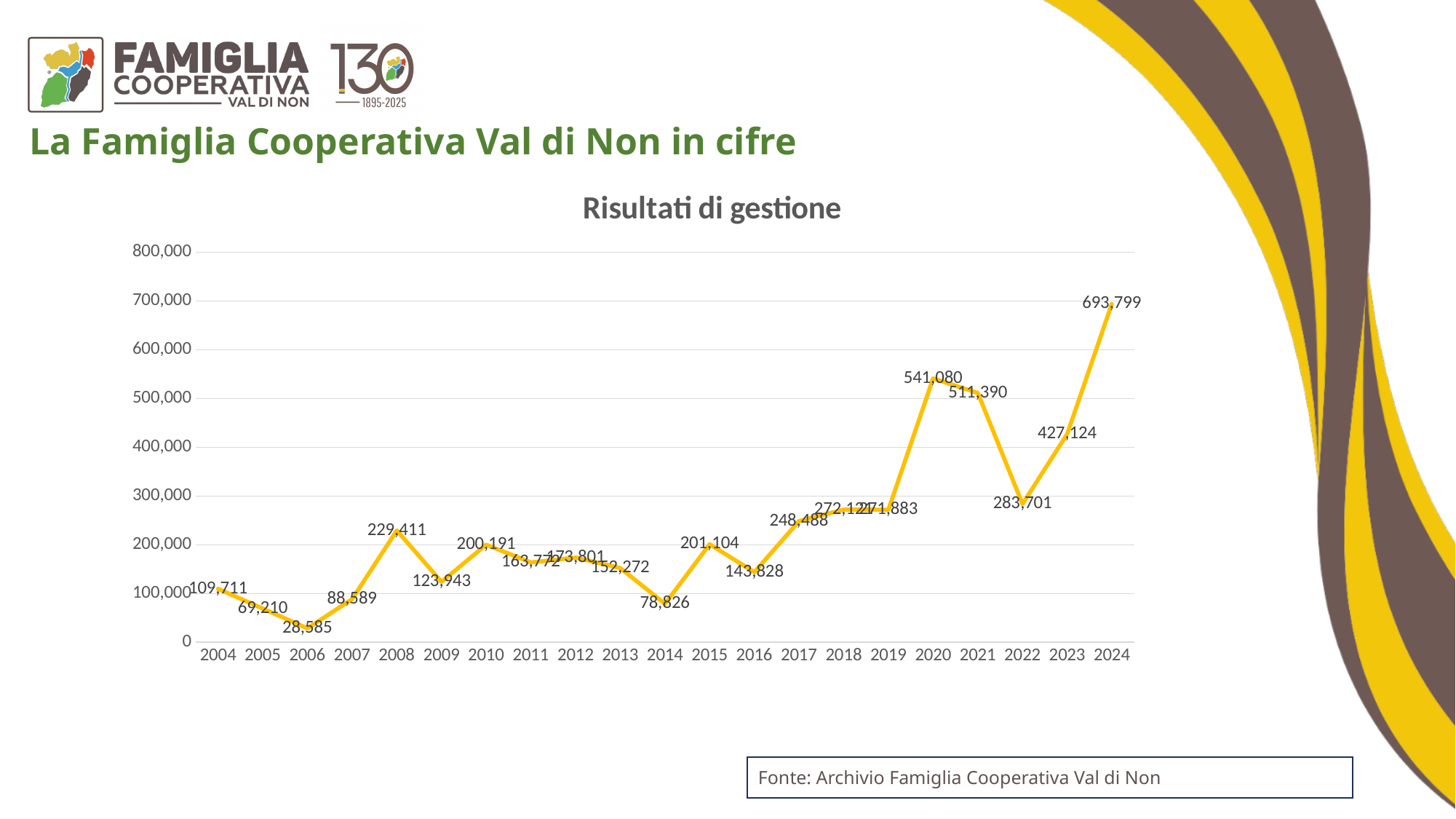
What is the value for 2006 in the 'Risultati di gestione' chart? 28,585 What is the value for 2008 in the 'Risultati di gestione' chart? 229,411 What kind of chart is 'Risultati di gestione'? line chart Which year has the lowest value in the 'Risultati di gestione' chart? 2006 Is the value for 2022 in the 'Risultati di gestione' chart greater or less than 300,000? less Which year has the highest value in the 'Risultati di gestione' chart? 2024 Do the values in the 'Risultati di gestione' chart rise or fall from 2020 to 2022? fall What is the difference between the values for 2024 and 2020 in the 'Risultati di gestione' chart? 152,719 How many years are plotted in the 'Risultati di gestione' chart? 21 Which year has the larger value in the 'Risultati di gestione' chart, 2020 or 2021? 2020 What is the value for 2024 in the 'Risultati di gestione' chart? 693,799 What is the difference between the values for 2023 and 2022 in the 'Risultati di gestione' chart? 143,423